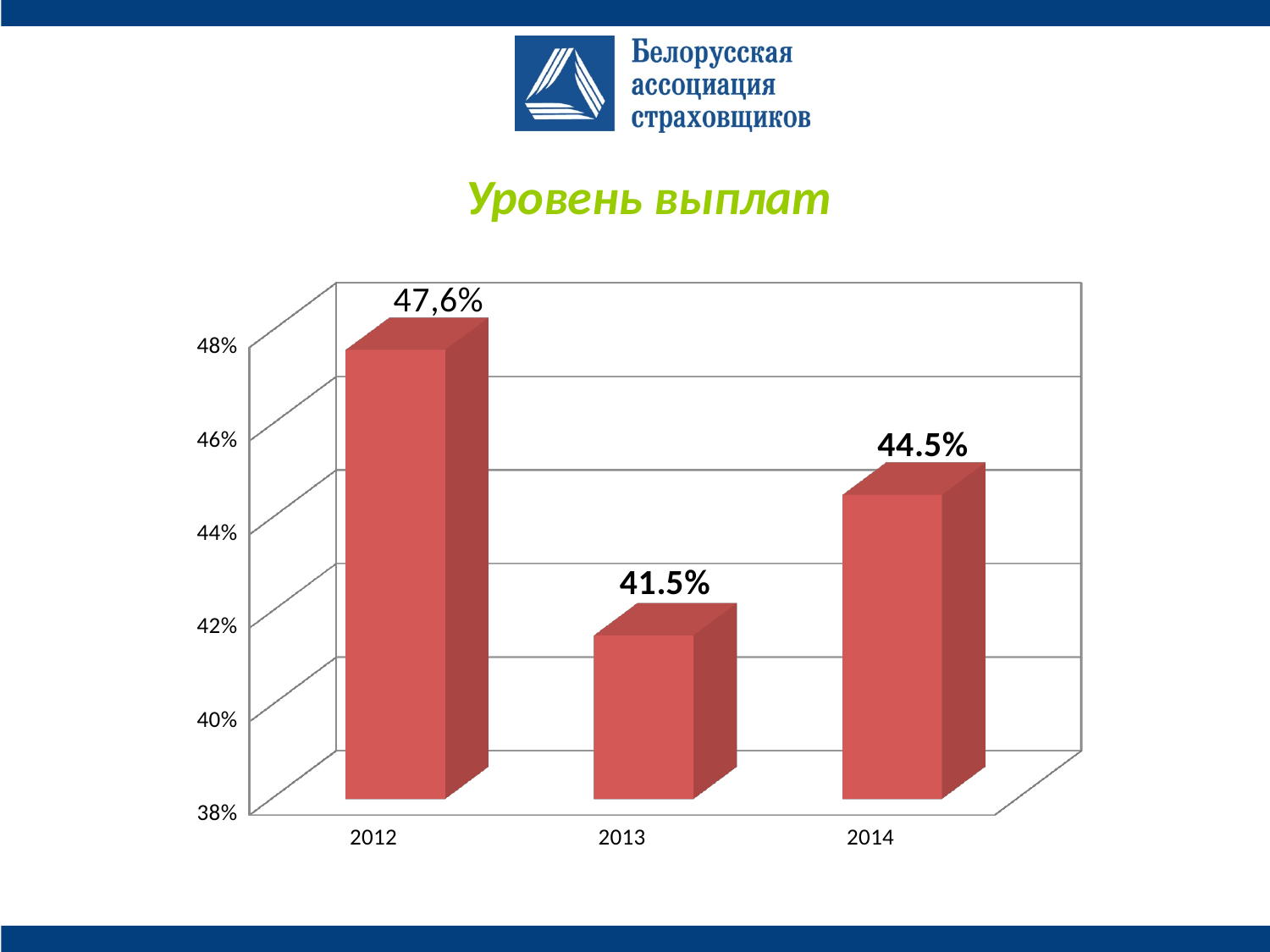
What is the difference between the values for 2014 and 2013? 3.0% Did the value rise or fall from 2013 to 2014? rise What is the title of the chart? Уровень выплат What is the value shown for 2012? 47,6% How many years are shown on the x axis? 3 Is the value for 2013 greater or less than 42%? less What is the value shown for 2014? 44.5% What kind of chart is this? bar chart Which is larger, the value for 2012 or the value for 2014? 2012 Which year has the lowest value? 2013 Which year has the highest value? 2012 What is the value shown for 2013? 41.5%